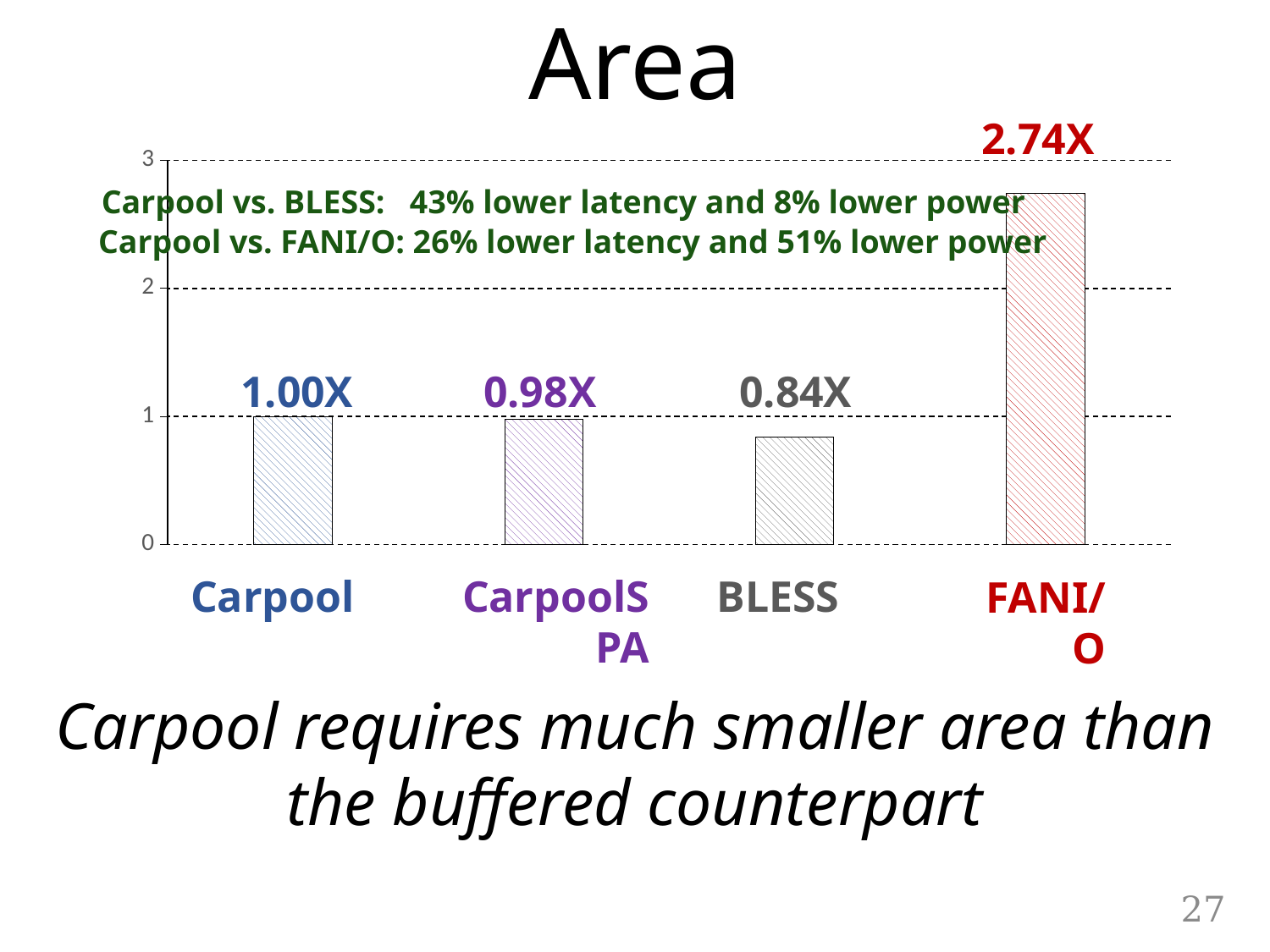
Which category has the lowest area value? BLESS What is the title of the chart? Area What kind of chart is shown on the slide? Bar chart What is the difference between the area values of FANI/O and Carpool? 1.74X What is the area value shown for CarpoolSPA? 0.98X Is the value for FANI/O greater or less than 2? greater What is the area value shown for BLESS? 0.84X Which has a larger area value, BLESS or FANI/O? FANI/O What is the area value shown for Carpool? 1.00X How many categories are shown in the chart? 4 What is the area value shown for FANI/O? 2.74X Which category has the highest area value? FANI/O